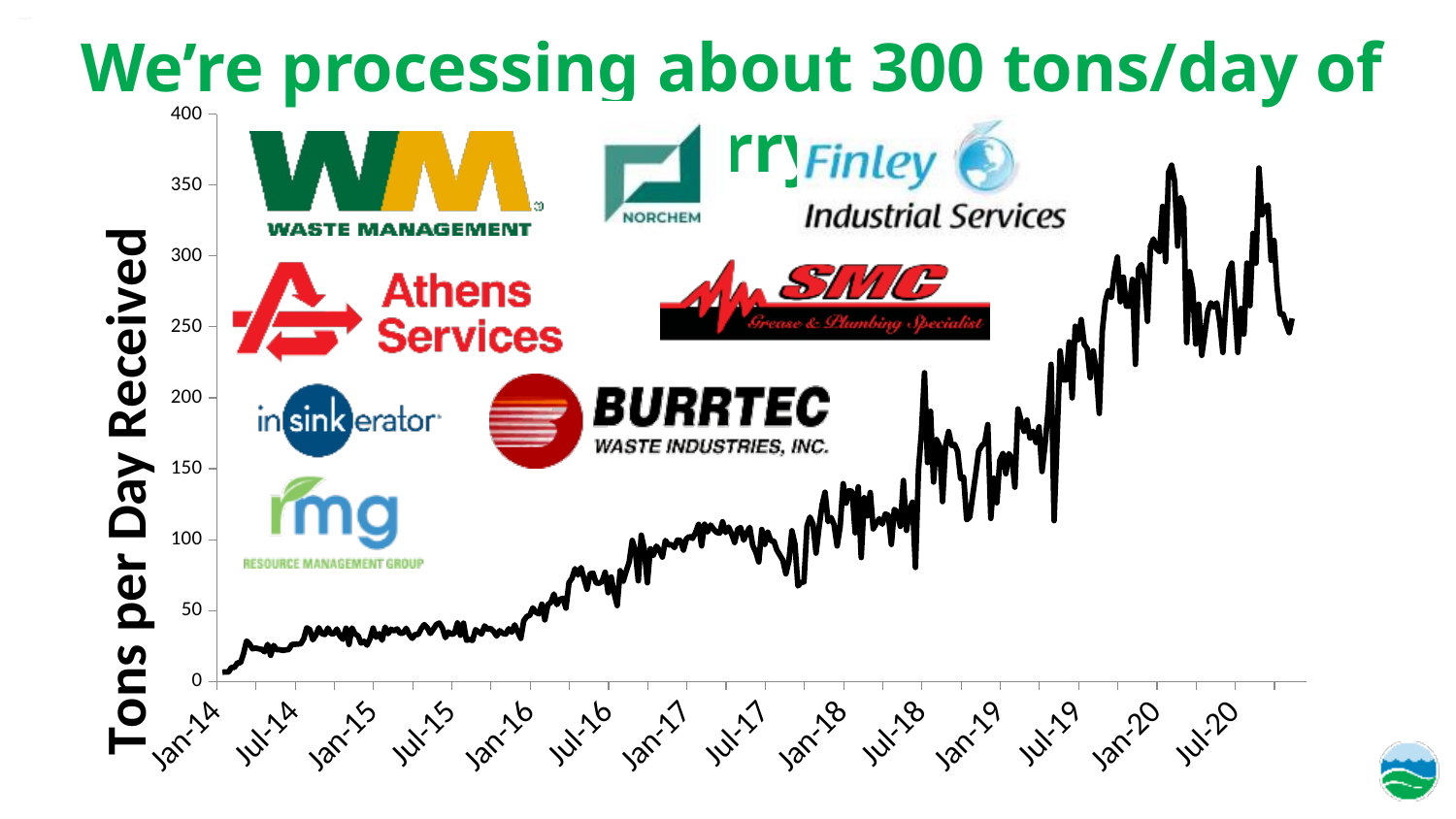
Which is larger, the value at Jan-20 or the value at Jan-14? Jan-20 What is the highest tick value shown on the vertical axis? 400 Overall, do the values rise or fall from Jan-14 to Jul-20? rise Is the value at Jul-17 greater or less than 50? greater What kind of chart is shown on the slide? line chart Is the value at Jul-20 greater or less than 200? greater Is the peak value of the line greater or less than 300? greater Which is larger, the value at Jul-16 or the value at Jul-14? Jul-16 What is the label on the vertical axis of the chart? Tons per Day Received